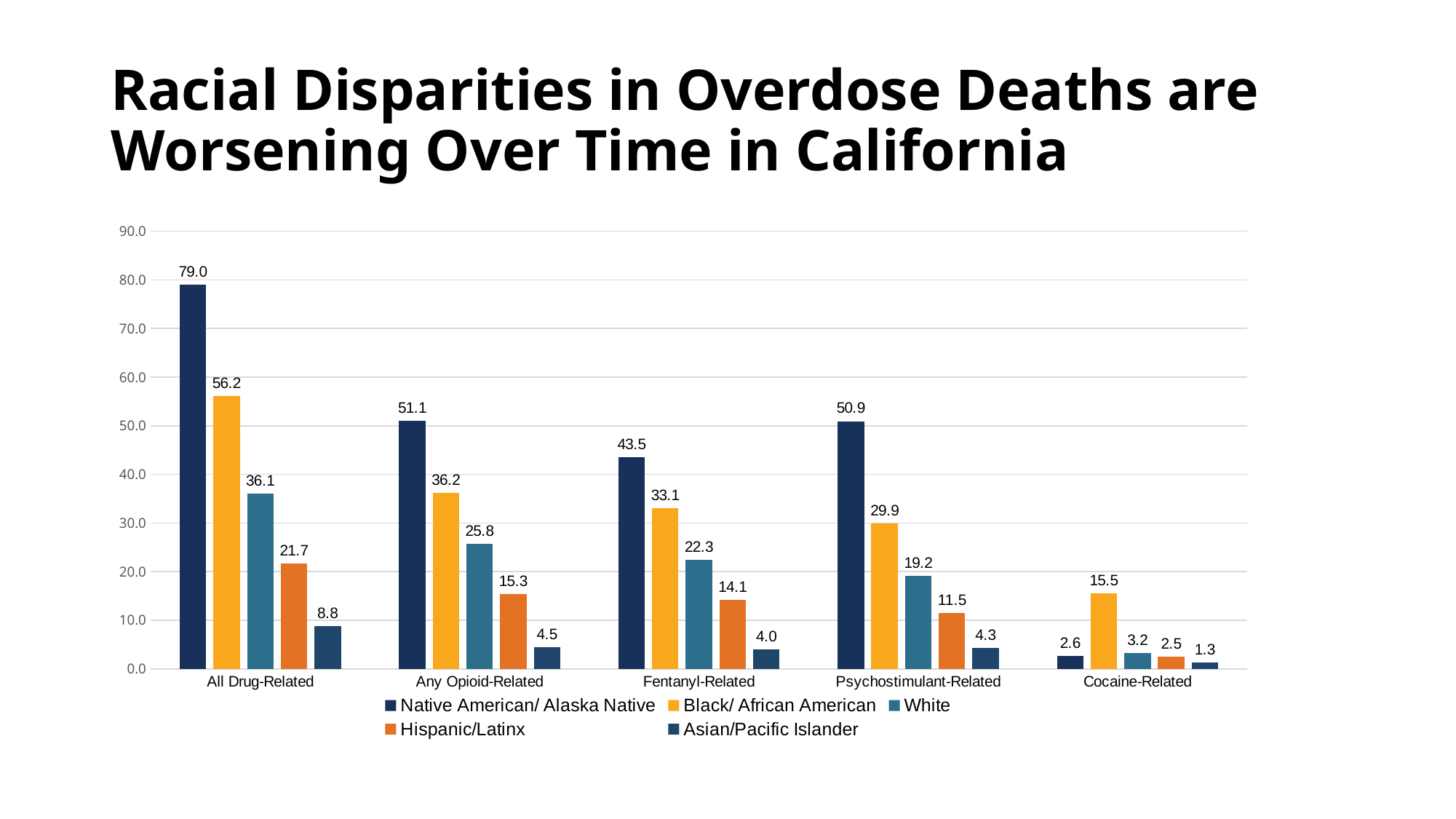
What is the value for Native American/ Alaska Native in the All Drug-Related category? 79.0 What is the value for Hispanic/Latinx in the Psychostimulant-Related category? 11.5 Which series has the lowest value in the Any Opioid-Related category? Asian/Pacific Islander What is the title of the slide? Racial Disparities in Overdose Deaths are Worsening Over Time in California What is the value for White in the Fentanyl-Related category? 22.3 How many categories are shown on the x axis? 5 What is the difference between the Native American/ Alaska Native and Black/ African American values in the All Drug-Related category? 22.8 How many series does the legend list? 5 Which is larger: the White value for Any Opioid-Related or the White value for Fentanyl-Related? Any Opioid-Related Which series has the highest value in the Cocaine-Related category? Black/ African American What kind of chart is shown on the slide? Bar chart What is the value for Black/ African American in the Cocaine-Related category? 15.5